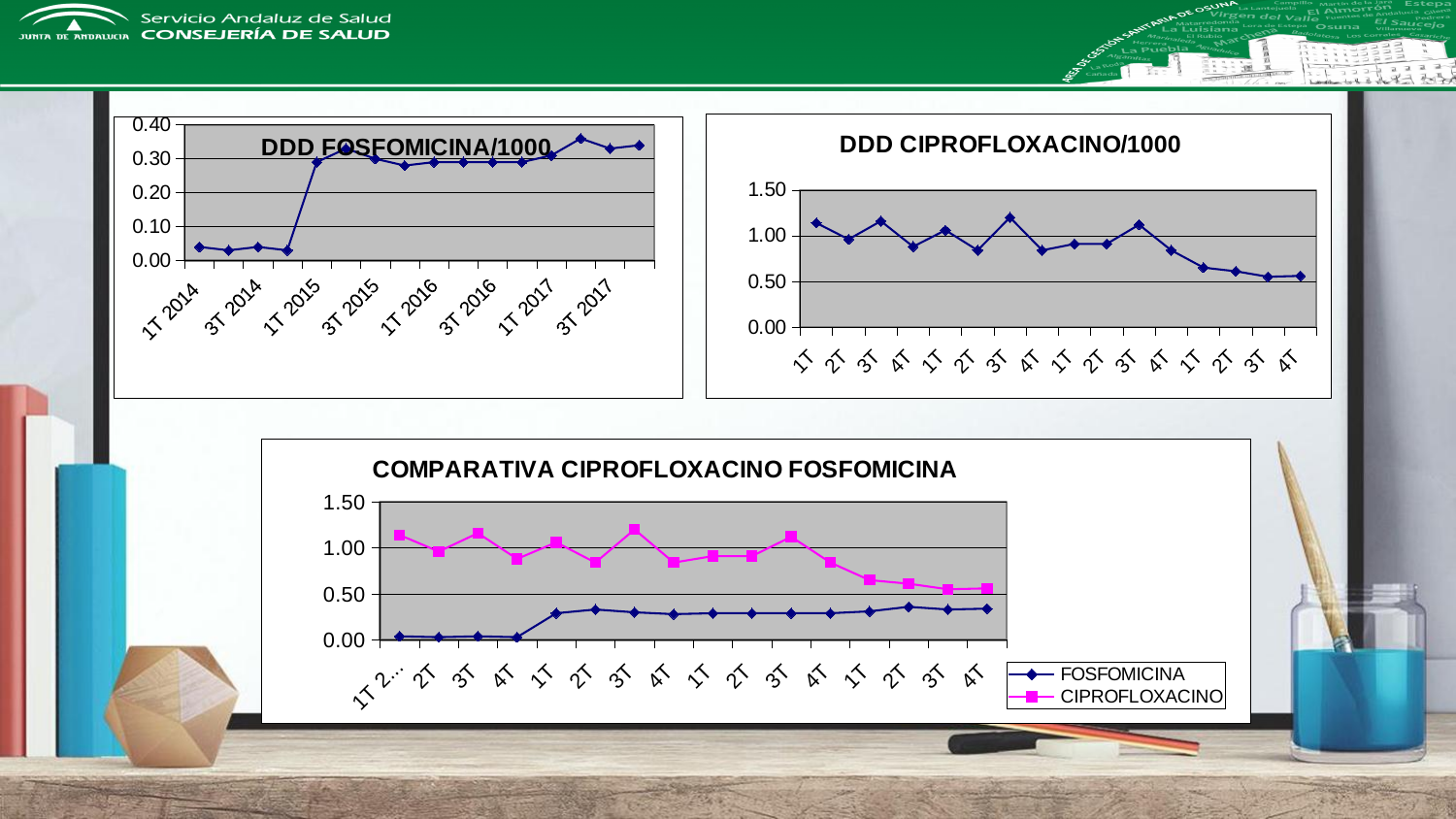
What kind of chart is the 'COMPARATIVA CIPROFLOXACINO FOSFOMICINA' chart? line chart How many series does the legend of the 'COMPARATIVA CIPROFLOXACINO FOSFOMICINA' chart list? 2 In the 'COMPARATIVA CIPROFLOXACINO FOSFOMICINA' chart, which series has the larger value at the first point on the x axis? CIPROFLOXACINO In the 'DDD CIPROFLOXACINO/1000' chart, do the values overall rise or fall from the first point to the last point? fall In the 'DDD CIPROFLOXACINO/1000' chart, is the value for the first point (1T) greater or less than 1.00? greater In the 'COMPARATIVA CIPROFLOXACINO FOSFOMICINA' chart, which series does the legend list first? FOSFOMICINA In the 'DDD CIPROFLOXACINO/1000' chart, is the value for the last point (4T) greater or less than 1.00? less In the 'DDD FOSFOMICINA/1000' chart, is the value for 1T 2014 greater or less than 0.10? less How many data points are plotted in the 'DDD CIPROFLOXACINO/1000' chart? 16 What kind of chart is the 'DDD FOSFOMICINA/1000' chart? line chart How many charts are shown on the slide? 3